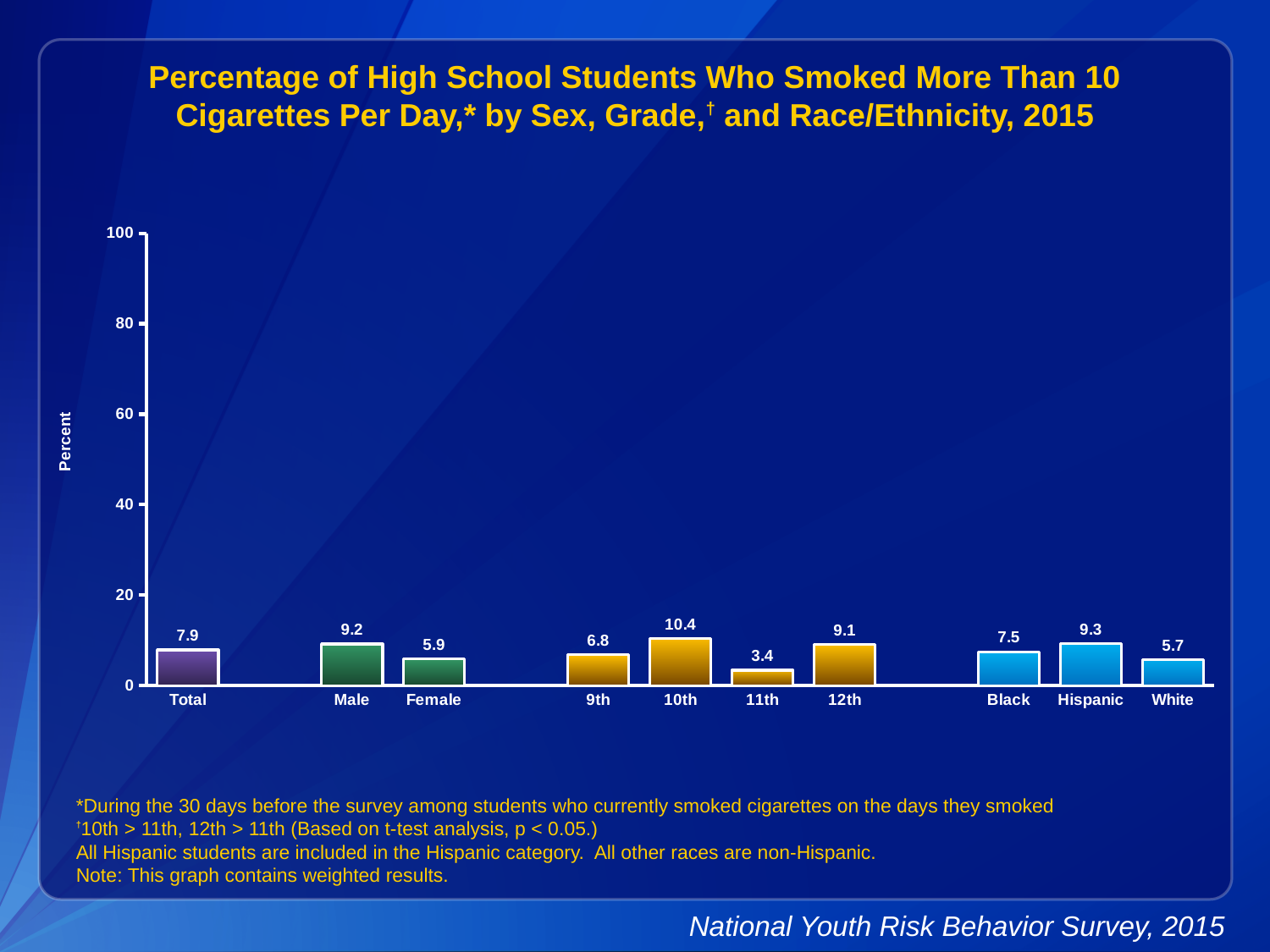
What is the value for Total? 7.9 What kind of chart is this? bar chart Which category has the lowest value? 11th What is the value for 11th grade? 3.4 What is the value for Hispanic? 9.3 What is the label of the y axis? Percent What is the value for Male? 9.2 Which is larger, the value for Black or the value for White? Black What is the difference between the Male and Female values? 3.3 Is the value for 12th grade greater or less than 20? less How many categories are shown on the x axis? 10 Which category has the highest value? 10th